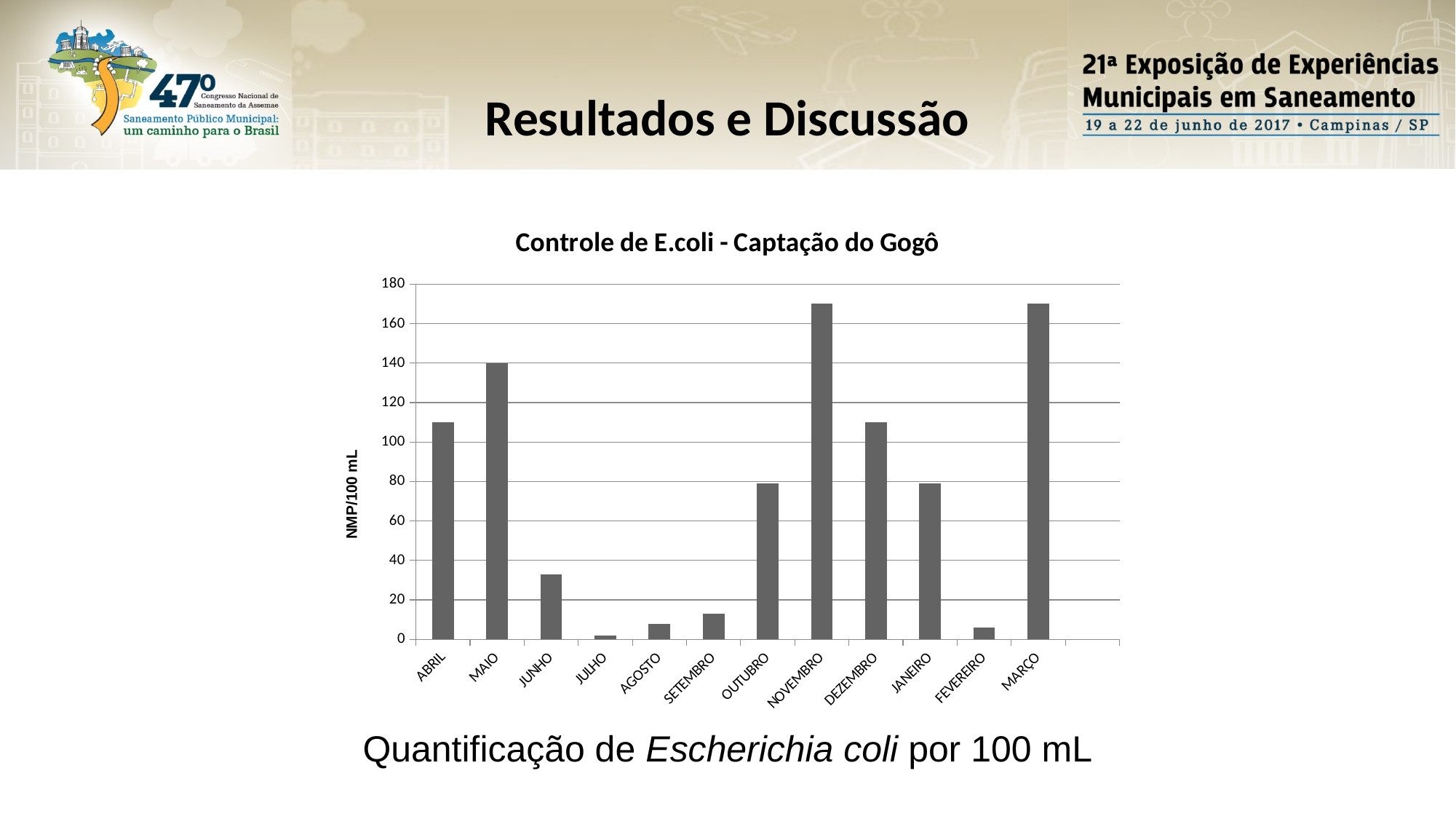
What type of chart is shown on the slide? bar chart Is the value for ABRIL greater or less than 100? greater How many months (categories) are plotted on the chart? 12 Which is larger, the value for MAIO or the value for ABRIL? MAIO What is the title of the chart? Controle de E.coli - Captação do Gogô Is the value for AGOSTO greater or less than 20? less Is the value for JUNHO greater or less than 40? less What is the label of the vertical axis? NMP/100 mL Which month has the lowest value? JULHO Which is larger, the value for JUNHO or the value for SETEMBRO? JUNHO What is the value for MAIO? 140